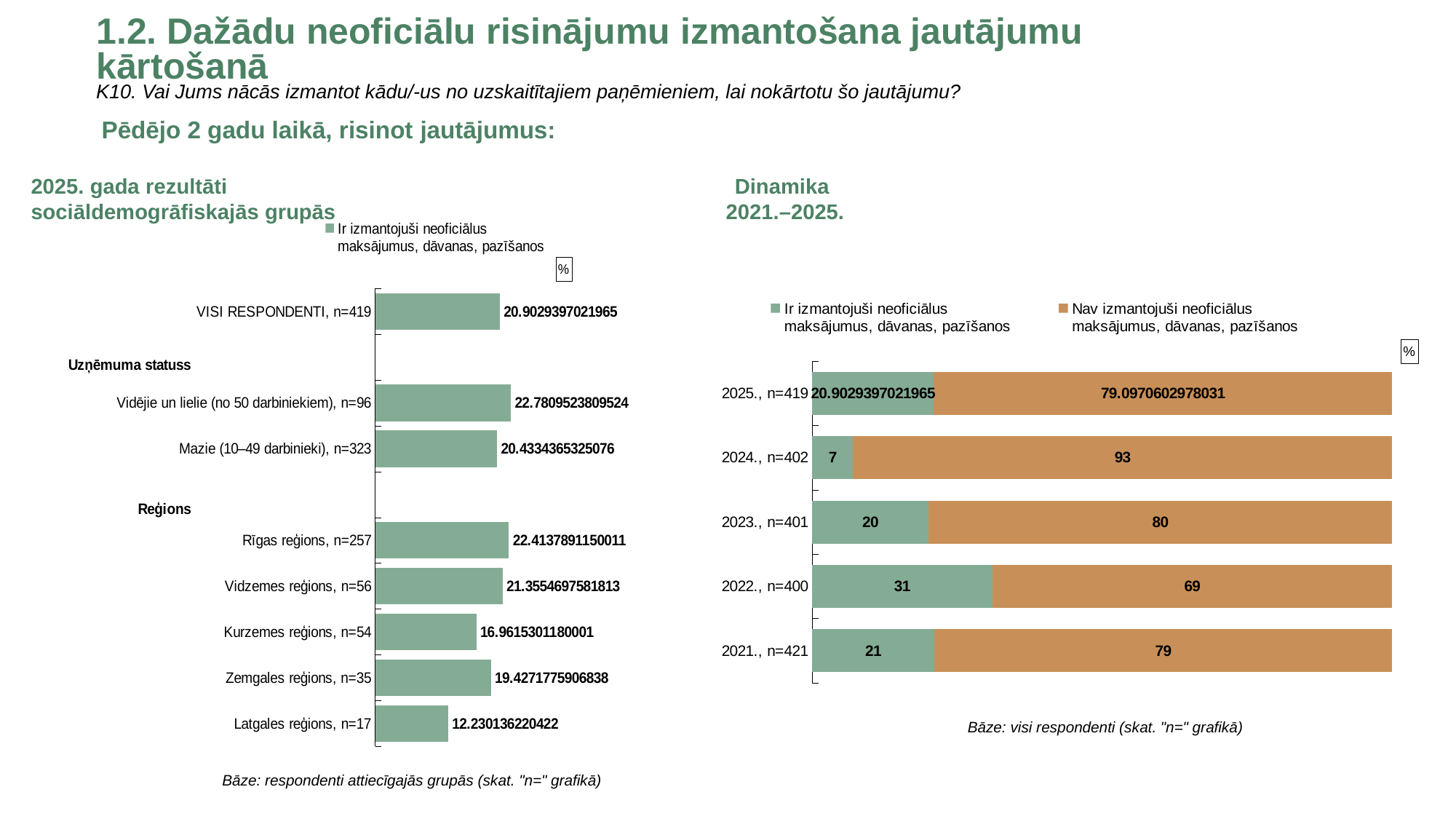
In the left chart (2025. gada rezultāti sociāldemogrāfiskajās grupās), what is the value for VISI RESPONDENTI, n=419? 20.9029397021965 In the left chart (2025. gada rezultāti sociāldemogrāfiskajās grupās), which is larger: the value for Kurzemes reģions, n=54 or Zemgales reģions, n=35? Zemgales reģions, n=35 In the right chart (Dinamika 2021.–2025.), which year has the highest value for 'Ir izmantojuši neoficiālus maksājumus, dāvanas, pazīšanos'? 2022., n=400 In the right chart (Dinamika 2021.–2025.), what is the value for 'Nav izmantojuši neoficiālus maksājumus, dāvanas, pazīšanos' in 2022., n=400? 69 In the right chart (Dinamika 2021.–2025.), how many series does the legend list? 2 In the right chart (Dinamika 2021.–2025.), what is the difference between the 'Nav izmantojuši' value and the 'Ir izmantojuši' value for 2023., n=401? 60 In the left chart (2025. gada rezultāti sociāldemogrāfiskajās grupās), how many categories have bars plotted? 8 In the left chart (2025. gada rezultāti sociāldemogrāfiskajās grupās), which category has the highest value? Vidējie un lielie (no 50 darbiniekiem), n=96 In the left chart (2025. gada rezultāti sociāldemogrāfiskajās grupās), which category has the lowest value? Latgales reģions, n=17 In the left chart (2025. gada rezultāti sociāldemogrāfiskajās grupās), what is the value for Latgales reģions, n=17? 12.230136220422 What kind of chart is the right chart (Dinamika 2021.–2025.)? Stacked bar chart In the right chart (Dinamika 2021.–2025.), what is the value for 'Ir izmantojuši neoficiālus maksājumus, dāvanas, pazīšanos' in 2024., n=402? 7